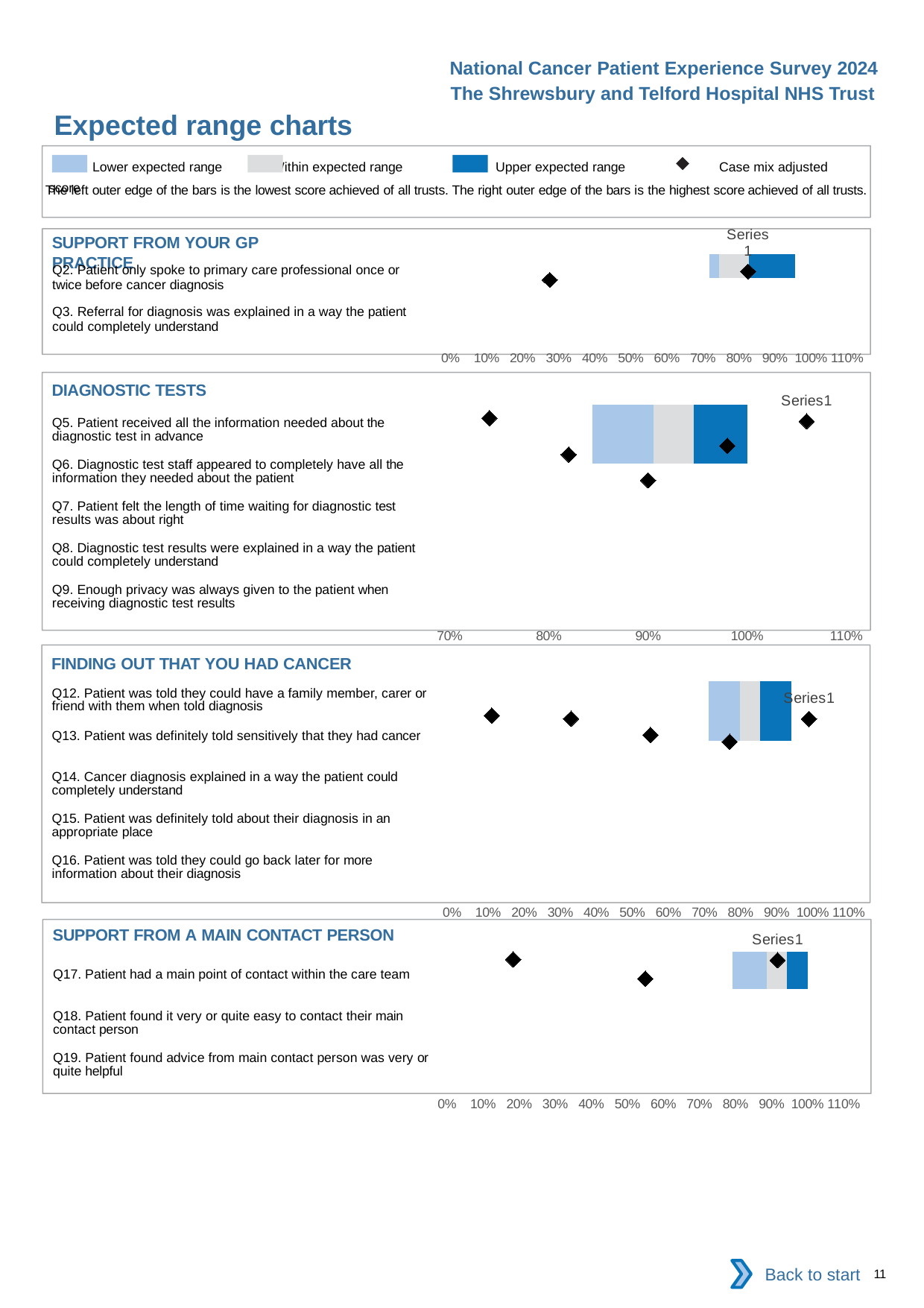
How many questions are listed in the 'Diagnostic tests' chart? 5 How many questions are listed in the 'Support from a main contact person' chart? 3 In the legend, which colour represents the upper expected range? Dark blue What is the title of the first chart section on the slide? Support from your GP practice What is the highest value shown on the x axis of the 'Support from a main contact person' chart? 110% How many questions are listed in the 'Support from your GP practice' chart? 2 How many entries does the legend at the top of the slide list? 4 What kind of chart is used in the 'Finding out that you had cancer' section? Bar chart What is the lowest value shown on the x axis of the 'Diagnostic tests' chart? 70%